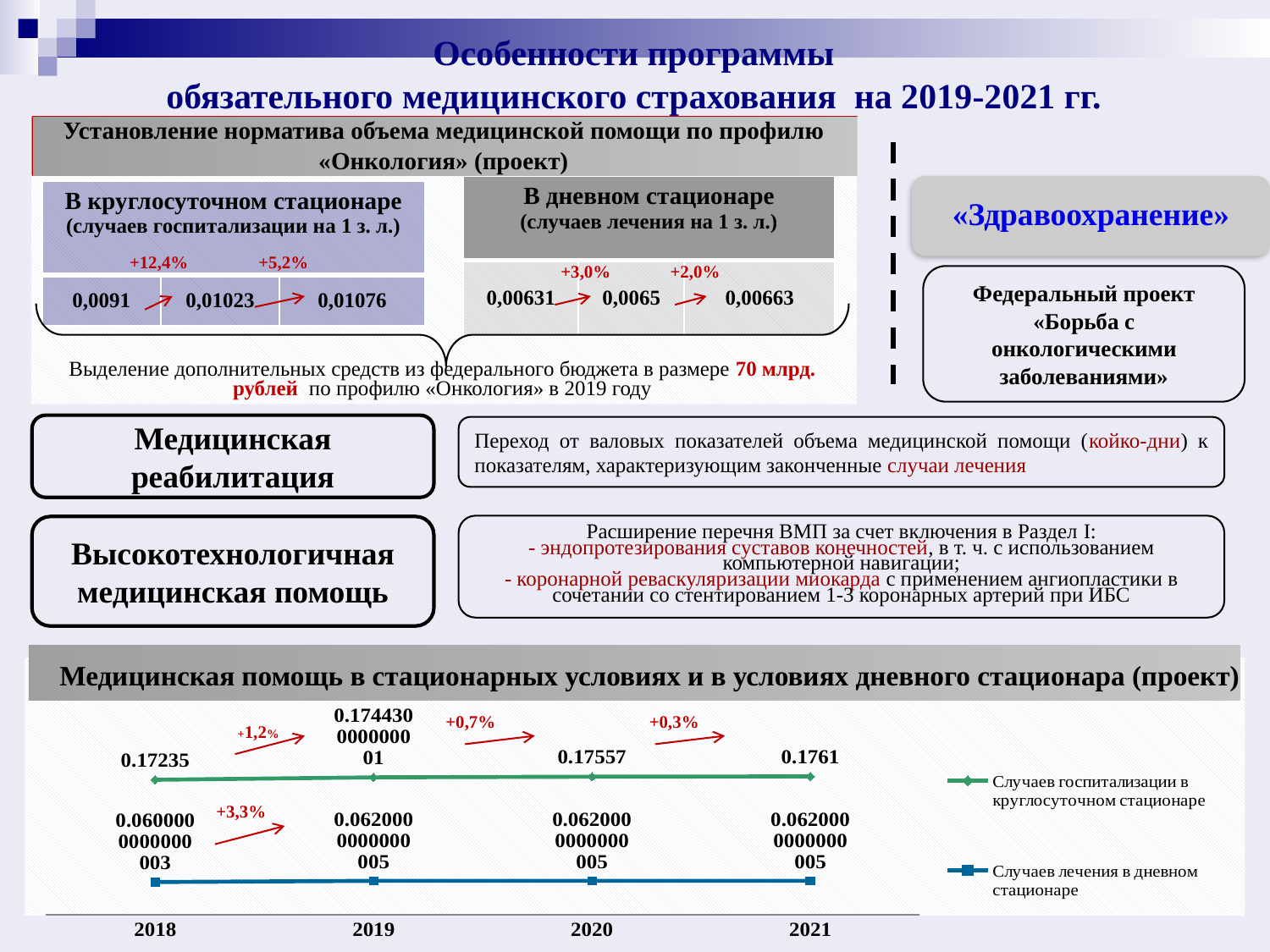
How many years are shown on the x axis of the bottom chart? 4 In the bottom chart, which year has the highest value for «Случаев госпитализации в круглосуточном стационаре»? 2021 In the bottom chart, what is the value for «Случаев госпитализации в круглосуточном стационаре» in 2021? 0.1761 In the bottom chart, what is the value for «Случаев госпитализации в круглосуточном стационаре» in 2020? 0.17557 In the bottom chart, what is the difference between the 2021 and 2020 values for «Случаев госпитализации в круглосуточном стационаре»? 0.00053 What kind of chart is shown at the bottom of the slide under the title «Медицинская помощь в стационарных условиях и в условиях дневного стационара (проект)»? line chart In the bottom chart, which series has the larger value in 2021: «Случаев госпитализации в круглосуточном стационаре» or «Случаев лечения в дневном стационаре»? Случаев госпитализации в круглосуточном стационаре In the bottom chart, what is the value for «Случаев госпитализации в круглосуточном стационаре» in 2018? 0.17235 In the bottom chart, do the values for «Случаев госпитализации в круглосуточном стационаре» rise or fall from 2018 to 2021? rise In the bottom chart, what percentage change is annotated between 2018 and 2019 for «Случаев лечения в дневном стационаре»? +3,3% How many series does the legend of the bottom chart list? 2 In the bottom chart, which year has the lowest value for «Случаев госпитализации в круглосуточном стационаре»? 2018